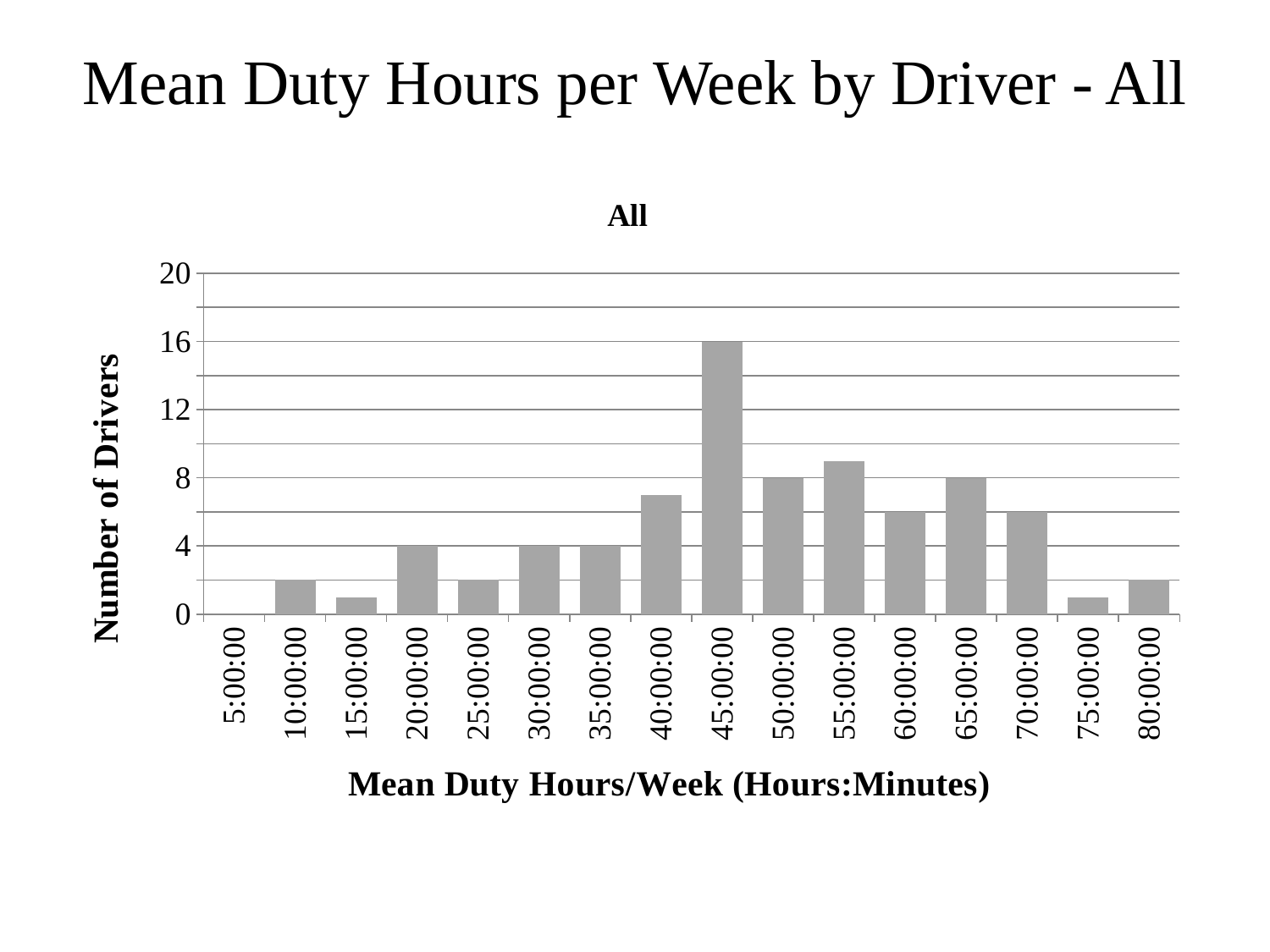
Which has more drivers, the 55:00:00 category or the 60:00:00 category? 55:00:00 Is the number of drivers for 75:00:00 greater or less than 4? less Which mean duty hours category has the highest number of drivers? 45:00:00 How many mean duty hours categories are shown on the x axis? 16 How many drivers are in the 20:00:00 category? 4 Is the number of drivers for 40:00:00 greater or less than 8? less What is the difference in number of drivers between the 45:00:00 and 50:00:00 categories? 8 How many drivers are in the 50:00:00 category? 8 How many drivers are in the 65:00:00 category? 8 What type of chart is shown on the slide? bar chart How many drivers are in the 45:00:00 category? 16 What is the title of the vertical axis? Number of Drivers